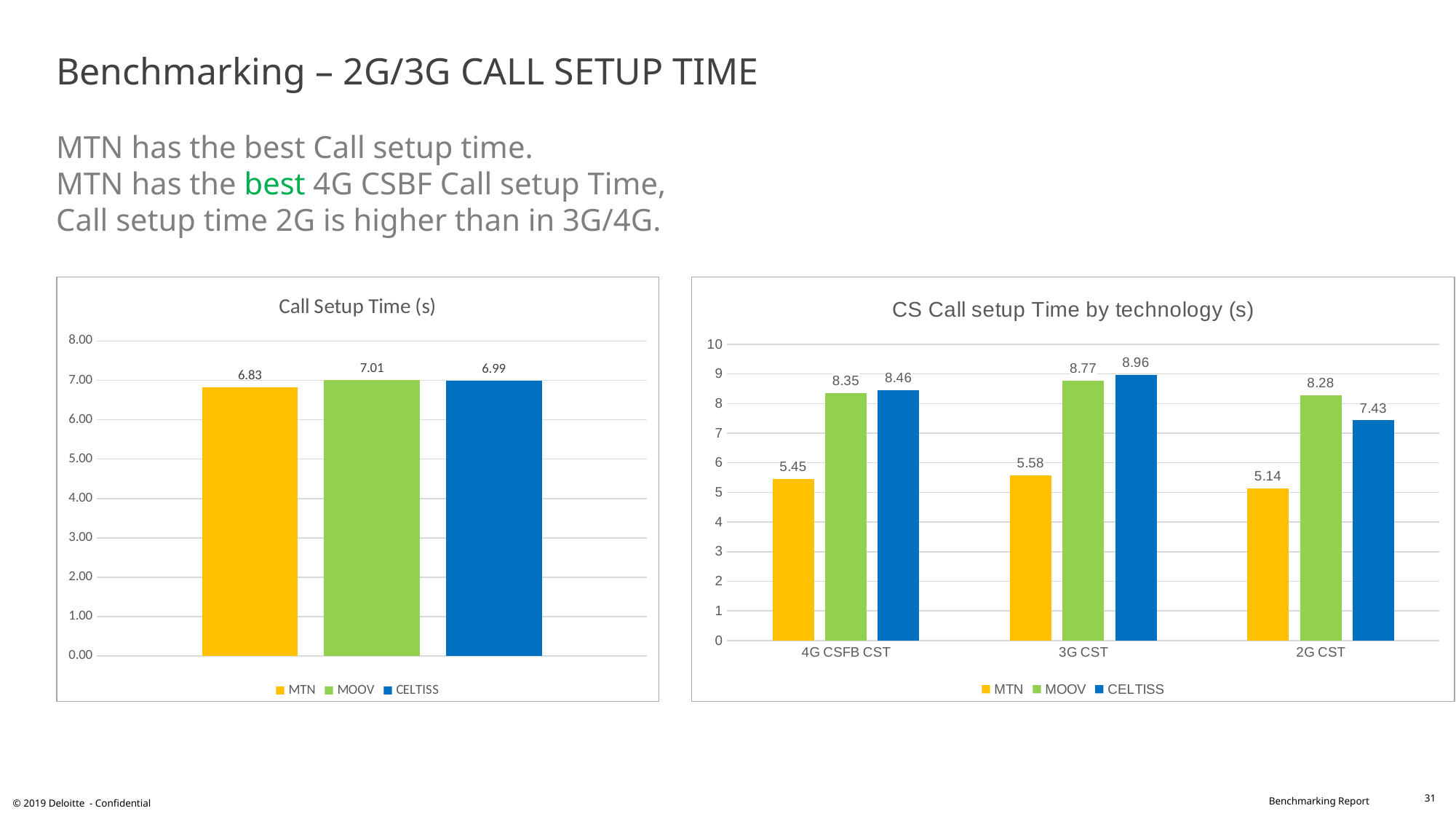
In the 'CS Call setup Time by technology (s)' chart, what is the value for MTN in the 2G CST category? 5.14 In the 'Call Setup Time (s)' chart, how many series does the legend list? 3 In the 'CS Call setup Time by technology (s)' chart, how many technology categories are shown on the x axis? 3 In the 'CS Call setup Time by technology (s)' chart, which operator has the lowest value in the 4G CSFB CST category? MTN In the 'CS Call setup Time by technology (s)' chart, what is the difference between the CELTISS and MTN values in the 3G CST category? 3.38 In the 'CS Call setup Time by technology (s)' chart, is the value for MOOV in 2G CST larger or smaller than the value for CELTISS in 2G CST? larger In the 'Call Setup Time (s)' chart, what is the difference between the MOOV and MTN values? 0.18 In the 'CS Call setup Time by technology (s)' chart, what is the value for CELTISS in the 3G CST category? 8.96 What kind of chart is the 'CS Call setup Time by technology (s)' chart? bar chart In the 'Call Setup Time (s)' chart, what is the value for MTN? 6.83 In the 'Call Setup Time (s)' chart, which operator has the lowest call setup time? MTN In the 'Call Setup Time (s)' chart, which operator has the highest call setup time? MOOV